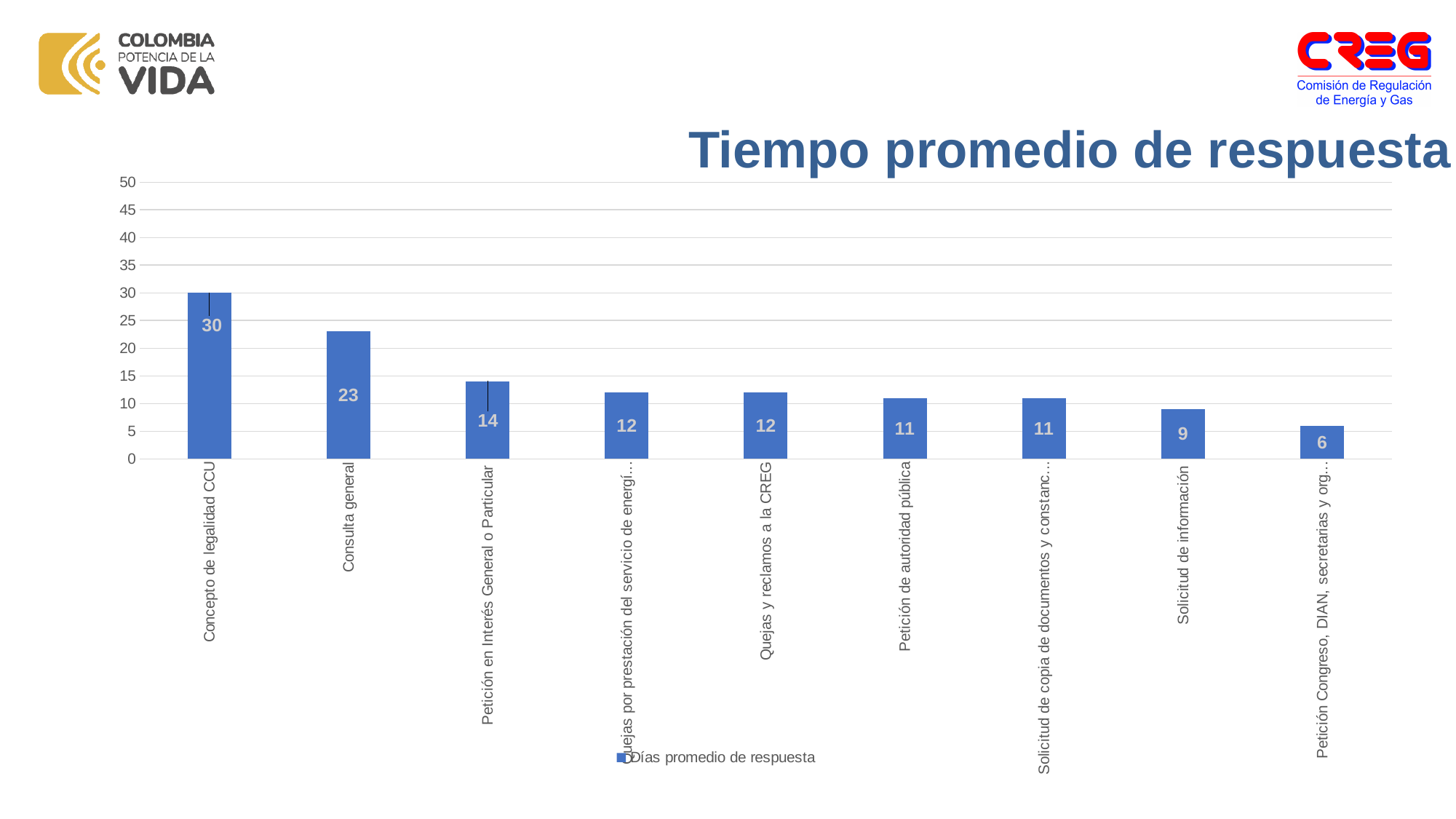
How many series does the legend list? 1 What is the value for Solicitud de información? 9 Which category has the highest value? Concepto de legalidad CCU Which is larger, the value for Petición en Interés General o Particular or the value for Solicitud de información? Petición en Interés General o Particular What is the value for Petición de autoridad pública? 11 What is the value for Consulta general? 23 Which category has the lowest value? Petición Congreso, DIAN, secretarias y org... How many categories are shown on the x axis? 9 What is the value for Quejas y reclamos a la CREG? 12 What is the title of the chart? Tiempo promedio de respuesta What kind of chart is shown? bar chart What is the difference between the values for Concepto de legalidad CCU and Consulta general? 7